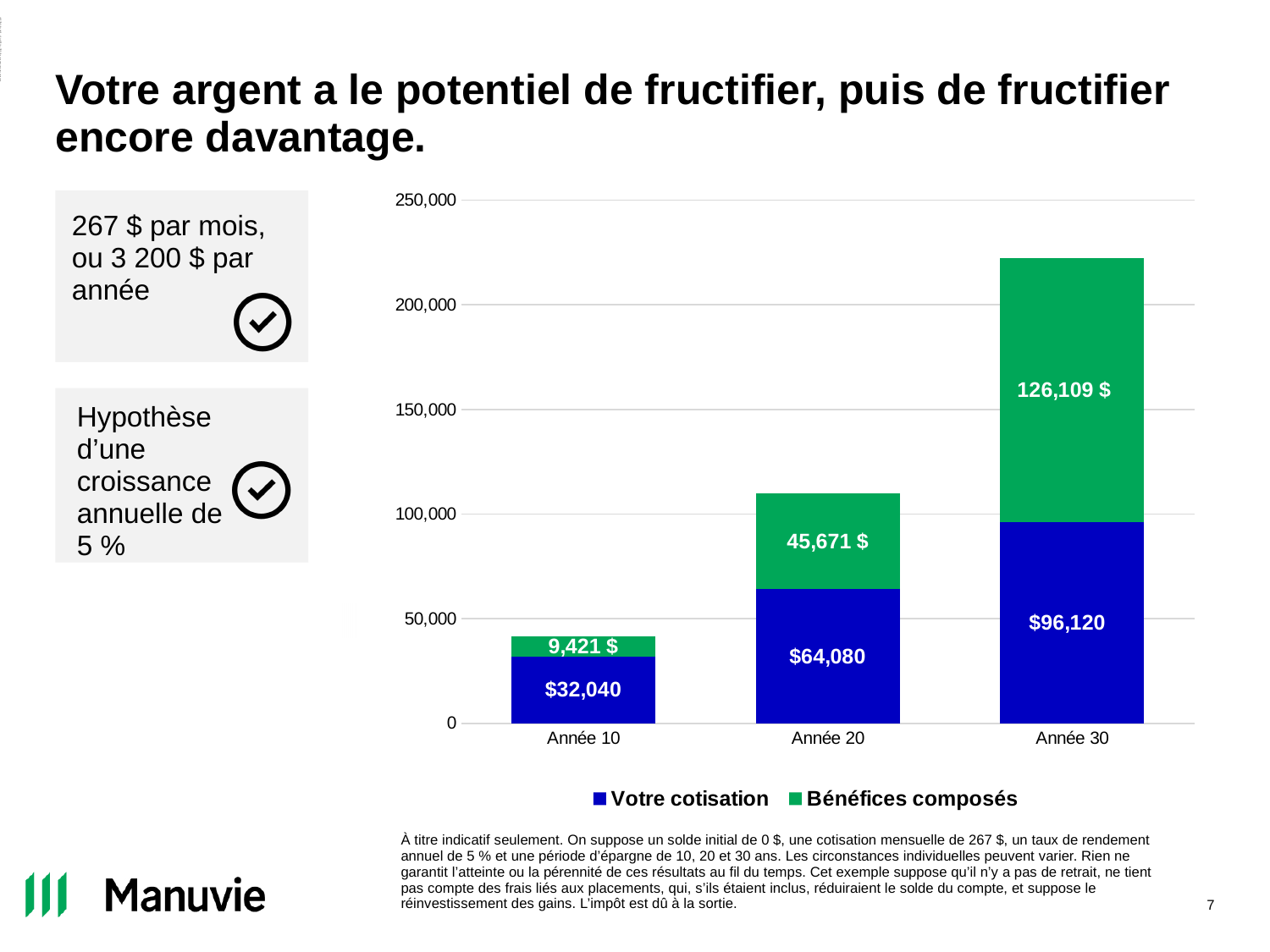
What is the value of Bénéfices composés for Année 10? 9,421 $ What is the total of the stacked bar for Année 20? 109,751 What is the value of Bénéfices composés for Année 30? 126,109 $ For Année 30, which is larger: Votre cotisation or Bénéfices composés? Bénéfices composés Which category has the lowest value for Votre cotisation? Année 10 How many series does the legend list? 2 What kind of chart is shown on the slide? Stacked bar chart Is the total stacked bar for Année 30 greater or less than 200,000? greater What is the value of Votre cotisation for Année 20? $64,080 What is the difference between Votre cotisation for Année 30 and Année 10? $64,080 How many categories are shown on the x axis? 3 Which category has the highest value for Bénéfices composés? Année 30